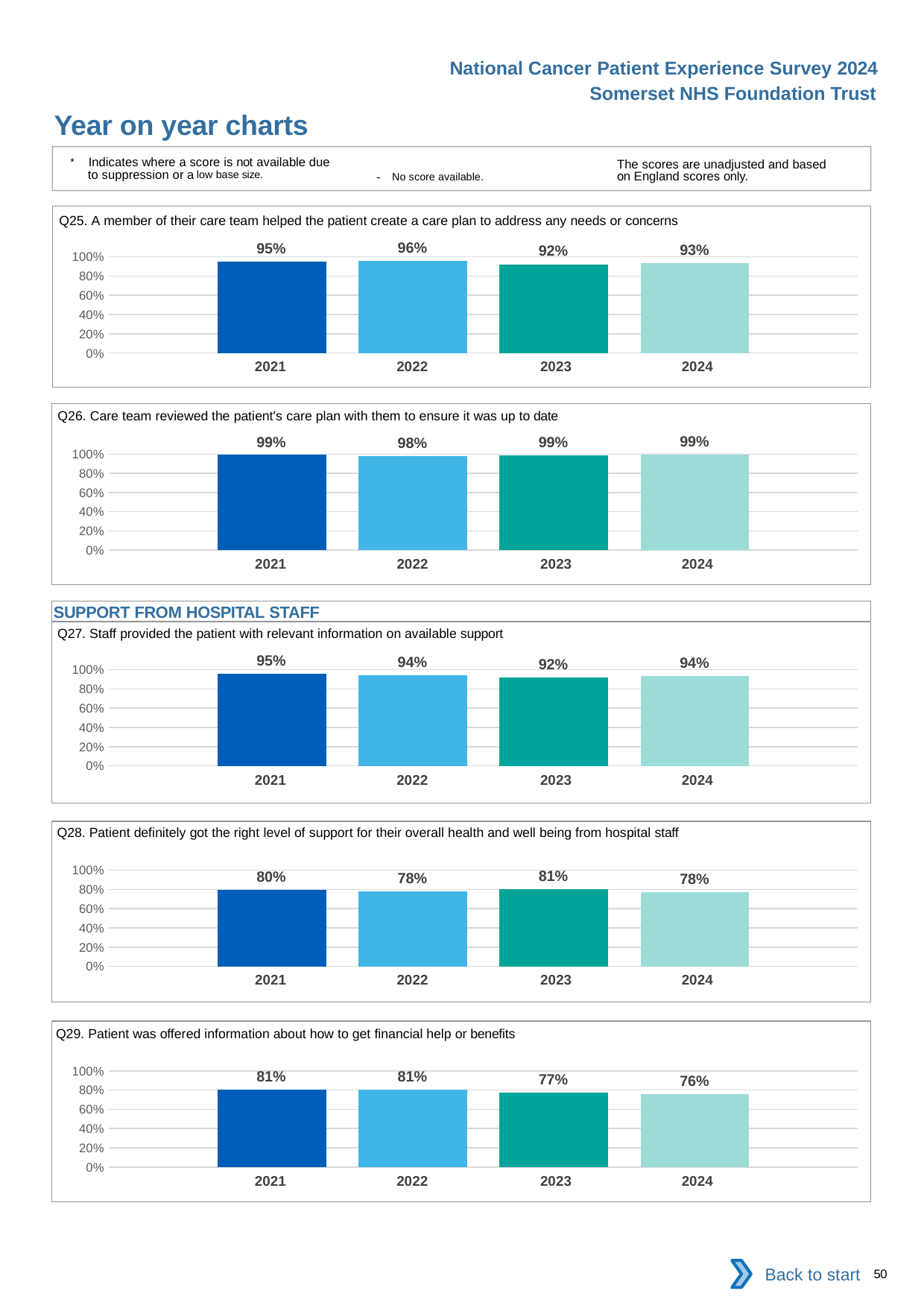
In the Q27 chart, which year has the highest value? 2021 In the Q29 chart, do the values rise or fall from 2022 to 2024? fall In the Q27 chart, what is the difference between the 2021 value and the 2023 value? 3% What kind of chart is the Q28 chart? bar chart In the Q29 chart, is the value for 2023 greater or less than 80%? less In the Q28 chart, what is the value for 2023? 81% In the Q25 chart, which year has the lowest value? 2023 In the Q26 chart, what is the value for 2022? 98% In the Q29 chart, what is the value for 2024? 76% In the Q25 chart, what is the value for 2022? 96% In the Q28 chart, is the value for 2021 larger or smaller than the value for 2022? larger In the Q26 chart, how many years are plotted? 4